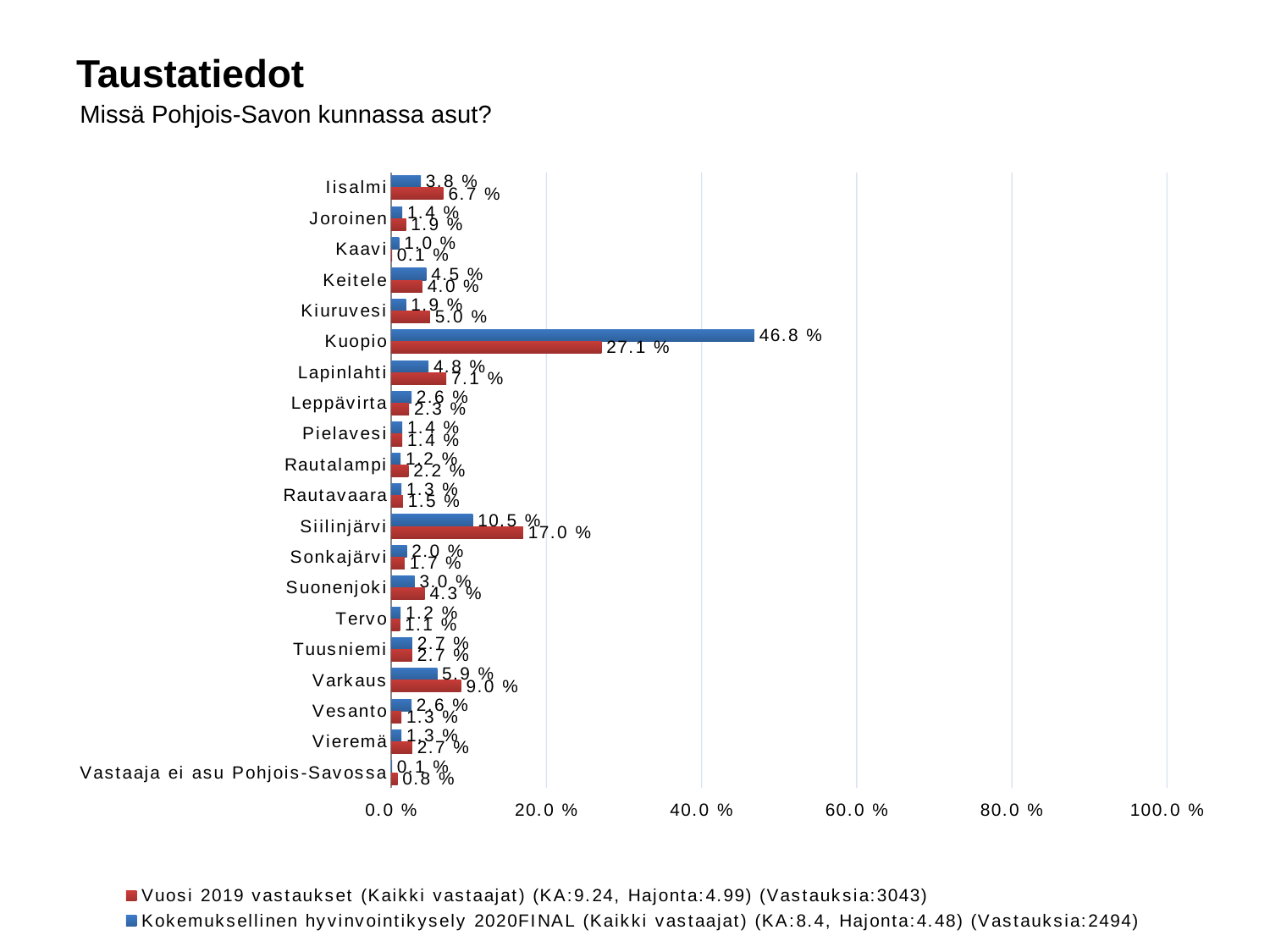
What is the question text shown under the slide title? Missä Pohjois-Savon kunnassa asut? How many categories (municipalities/options) are shown on the chart? 20 What is the value for Kuopio in the Kokemuksellinen hyvinvointikysely 2020FINAL series? 46.8 % What type of chart is shown on the slide? bar chart What is the value for Kuopio in the Vuosi 2019 vastaukset series? 27.1 % Is the value for Kuopio in the Kokemuksellinen hyvinvointikysely 2020FINAL series greater or less than 40.0 %? greater For Siilinjärvi, which series has the larger value: Vuosi 2019 vastaukset or Kokemuksellinen hyvinvointikysely 2020FINAL? Vuosi 2019 vastaukset How many series does the legend list? 2 What is the difference between the Kokemuksellinen hyvinvointikysely 2020FINAL value and the Vuosi 2019 vastaukset value for Kuopio? 19.7 % What is the value for Siilinjärvi in the Vuosi 2019 vastaukset series? 17.0 % Which category has the highest value in the Kokemuksellinen hyvinvointikysely 2020FINAL series? Kuopio What is the value for Varkaus in the Kokemuksellinen hyvinvointikysely 2020FINAL series? 5.9 %